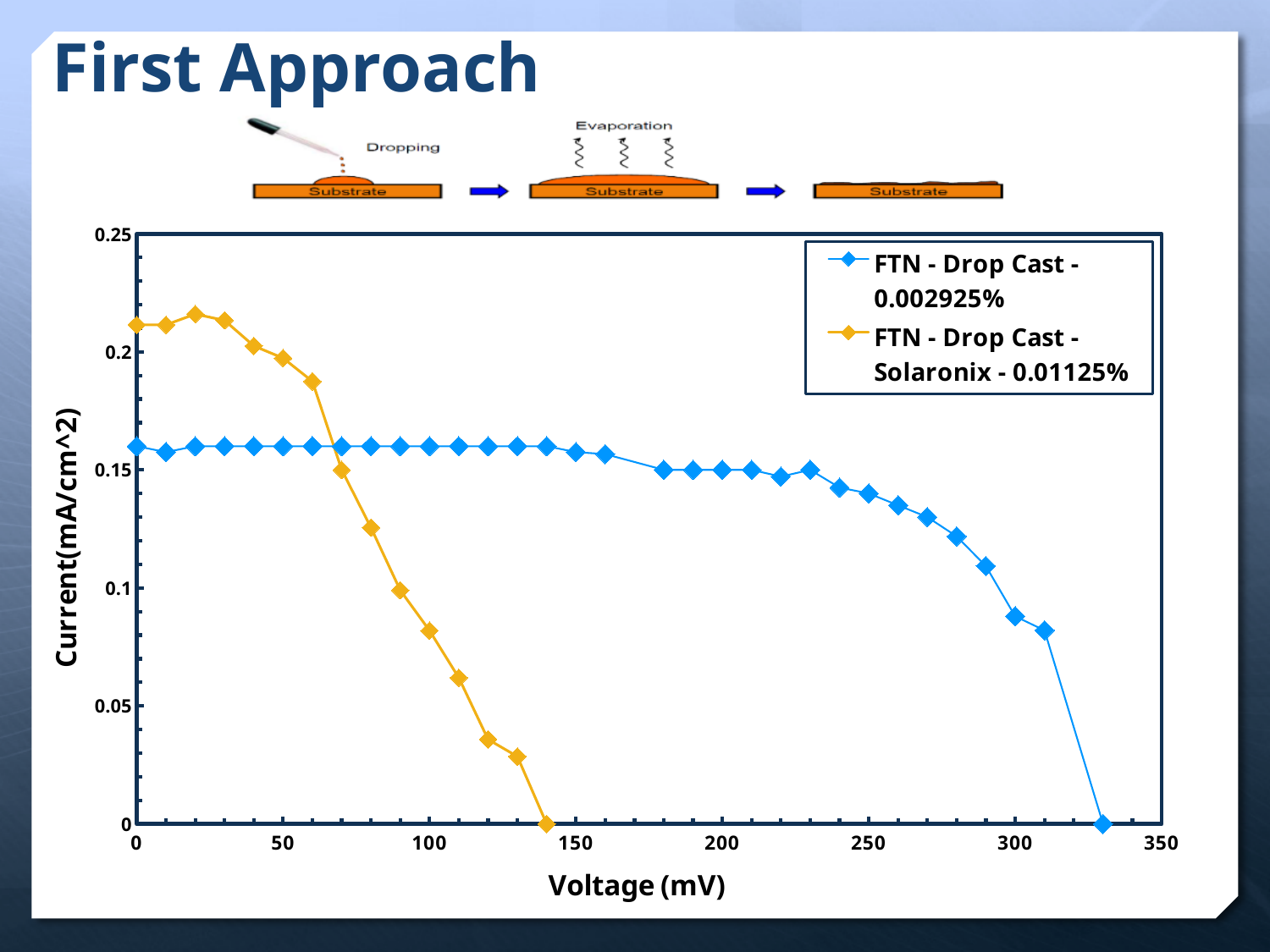
What is the label of the y axis? Current(mA/cm^2) At 100 mV, which series has the higher current? FTN - Drop Cast - 0.002925% What is the label of the x axis? Voltage (mV) Is the current for FTN - Drop Cast - Solaronix - 0.01125% at 20 mV greater or less than 0.2? greater At 50 mV, which series has the higher current? FTN - Drop Cast - Solaronix - 0.01125% At what voltage does the FTN - Drop Cast - 0.002925% series reach a current of 0? 330 Is the current for FTN - Drop Cast - Solaronix - 0.01125% at 120 mV greater or less than 0.05? less Is the current for FTN - Drop Cast - 0.002925% at 300 mV greater or less than 0.1? less How many series does the legend list? 2 What kind of chart is shown on the slide? line chart At what voltage does the FTN - Drop Cast - Solaronix - 0.01125% series reach a current of 0? 140